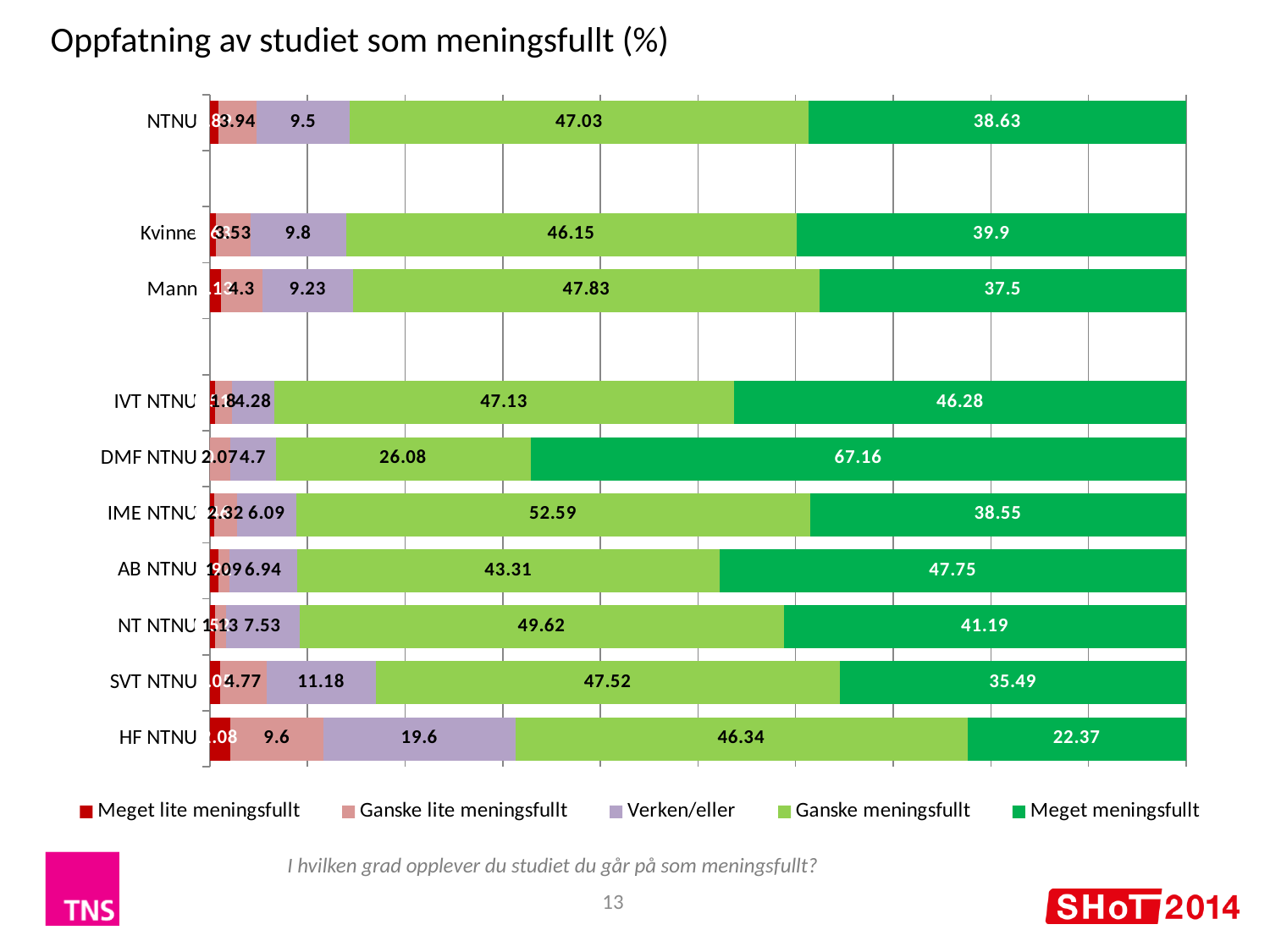
Which is larger, the "Meget meningsfullt" value for AB NTNU or for NT NTNU? AB NTNU What is the value of "Verken/eller" for HF NTNU? 19.6 How many categories are plotted on the chart? 10 How many series does the legend list? 5 Which category has the highest value for "Verken/eller"? HF NTNU What type of chart is shown on the slide? stacked bar chart What is the value of "Meget meningsfullt" for Kvinne? 39.9 What is the value of "Meget meningsfullt" for DMF NTNU? 67.16 What is the difference between the "Meget meningsfullt" values for DMF NTNU and HF NTNU? 44.79 What is the value of "Ganske meningsfullt" for IME NTNU? 52.59 Which category has the highest value for "Meget meningsfullt"? DMF NTNU Which category has the lowest value for "Meget meningsfullt"? HF NTNU